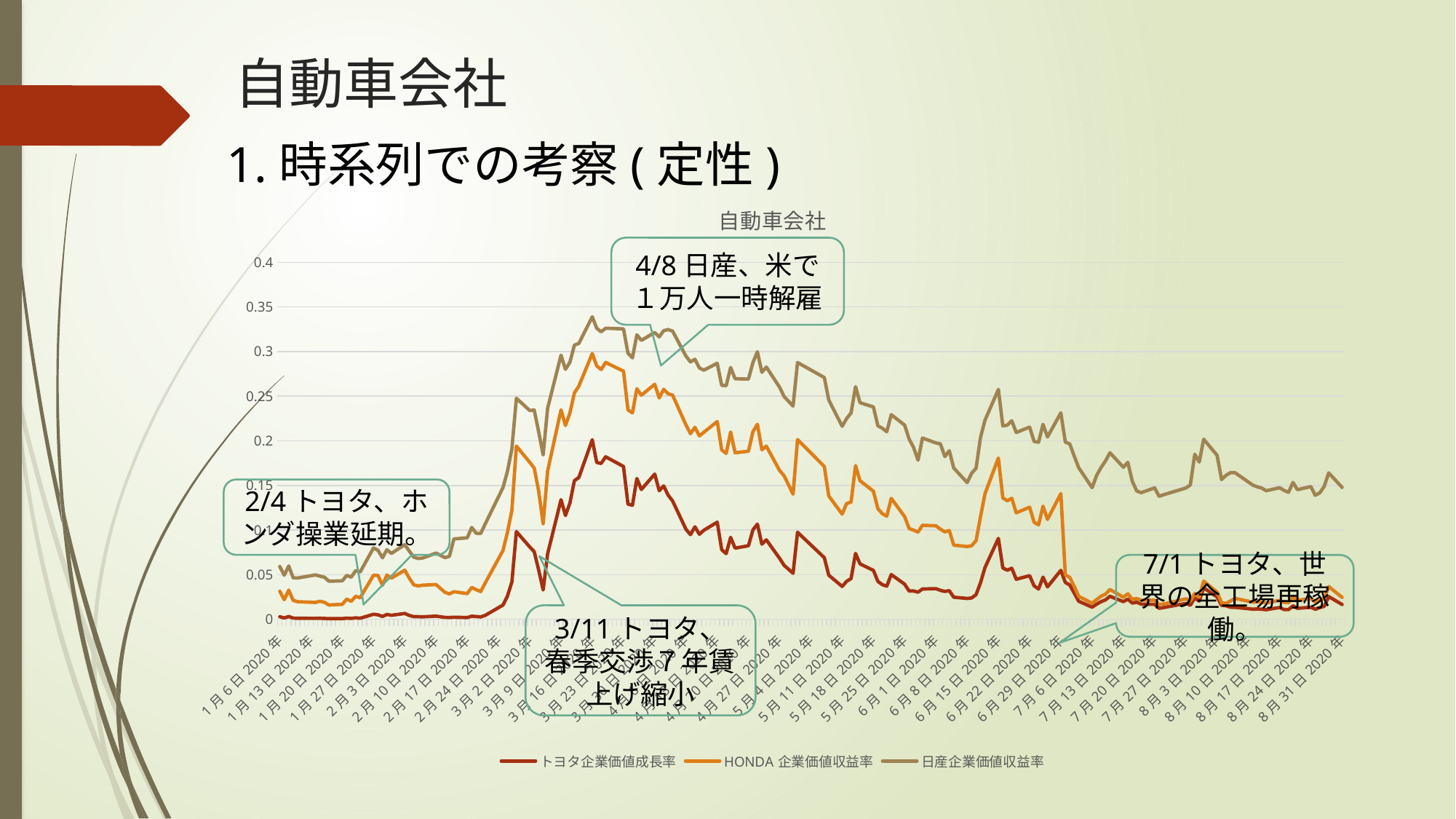
Is the value for 日産企業価値収益率 on 8月31日 2020年 greater or less than 0.1? greater From late February to early April 2020, does 日産企業価値収益率 rise or fall? rise What kind of chart is shown on the slide? line chart Which series reaches the highest value on the chart? 日産企業価値収益率 How many series does the legend of the chart list? 3 From mid-April to the end of May 2020, does HONDA 企業価値収益率 rise or fall? fall Is the value for トヨタ企業価値成長率 on 1月6日 2020年 greater or less than 0.05? less Is the peak value of トヨタ企業価値成長率 greater or less than 0.25? less Which series stays lowest for most of the period shown? トヨタ企業価値成長率 What is the title of the chart? 自動車会社 In early April 2020, which series is higher, HONDA 企業価値収益率 or トヨタ企業価値成長率? HONDA 企業価値収益率